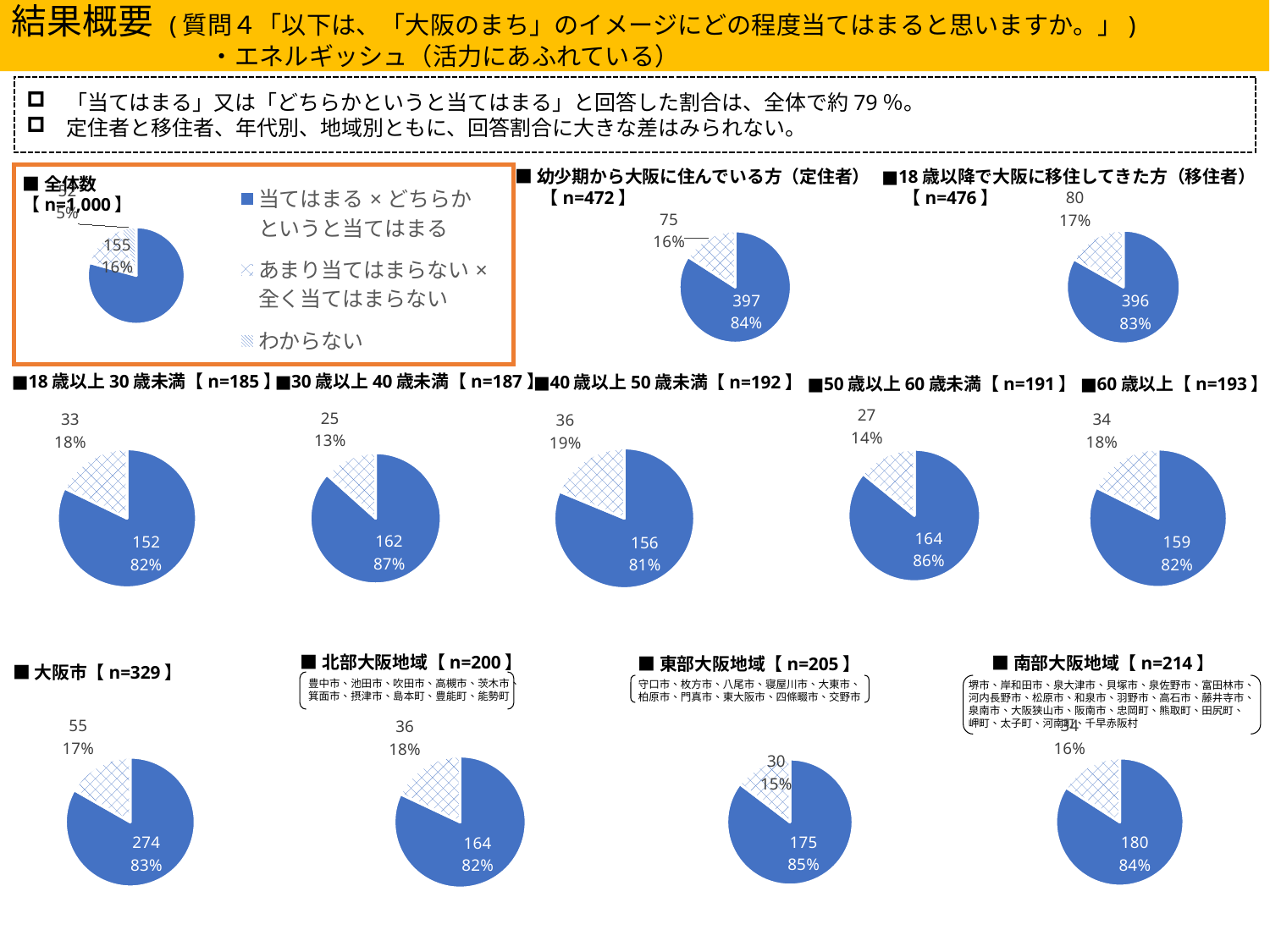
In the pie chart titled 「南部大阪地域」, what percentage is shown for the 「あまり当てはまらない × 全く当てはまらない」 slice? 16% In the pie chart titled 「30 歳以上 40 歳未満」, what percentage is shown for the 「当てはまる × どちらかというと当てはまる」 slice? 87% In the pie chart titled 「大阪市」, how many respondents are in the 「当てはまる × どちらかというと当てはまる」 slice? 274 How many pie charts are shown on the slide in total? 12 Among the five age-group pie charts, which age group has the highest percentage for 「当てはまる × どちらかというと当てはまる」? 30 歳以上 40 歳未満 What type of chart is used throughout this slide? Pie chart In the pie chart titled 「幼少期から大阪に住んでいる方（定住者）」, what percentage is shown for the 「当てはまる × どちらかというと当てはまる」 slice? 84% How many entries does the legend next to the 「全体数」 chart list? 3 What is the difference in respondent count for 「当てはまる × どちらかというと当てはまる」 between the 「幼少期から大阪に住んでいる方（定住者）」 chart (397) and the 「18 歳以降で大阪に移住してきた方（移住者）」 chart (396)? 1 In the pie chart titled 「18 歳以降で大阪に移住してきた方（移住者）」, how many respondents are in the 「あまり当てはまらない × 全く当てはまらない」 slice? 80 Among the five age-group pie charts, which age group has the lowest percentage for 「当てはまる × どちらかというと当てはまる」? 40 歳以上 50 歳未満 Comparing the 「東部大阪地域」 and 「北部大阪地域」 pie charts, which has the larger percentage for 「当てはまる × どちらかというと当てはまる」? 東部大阪地域